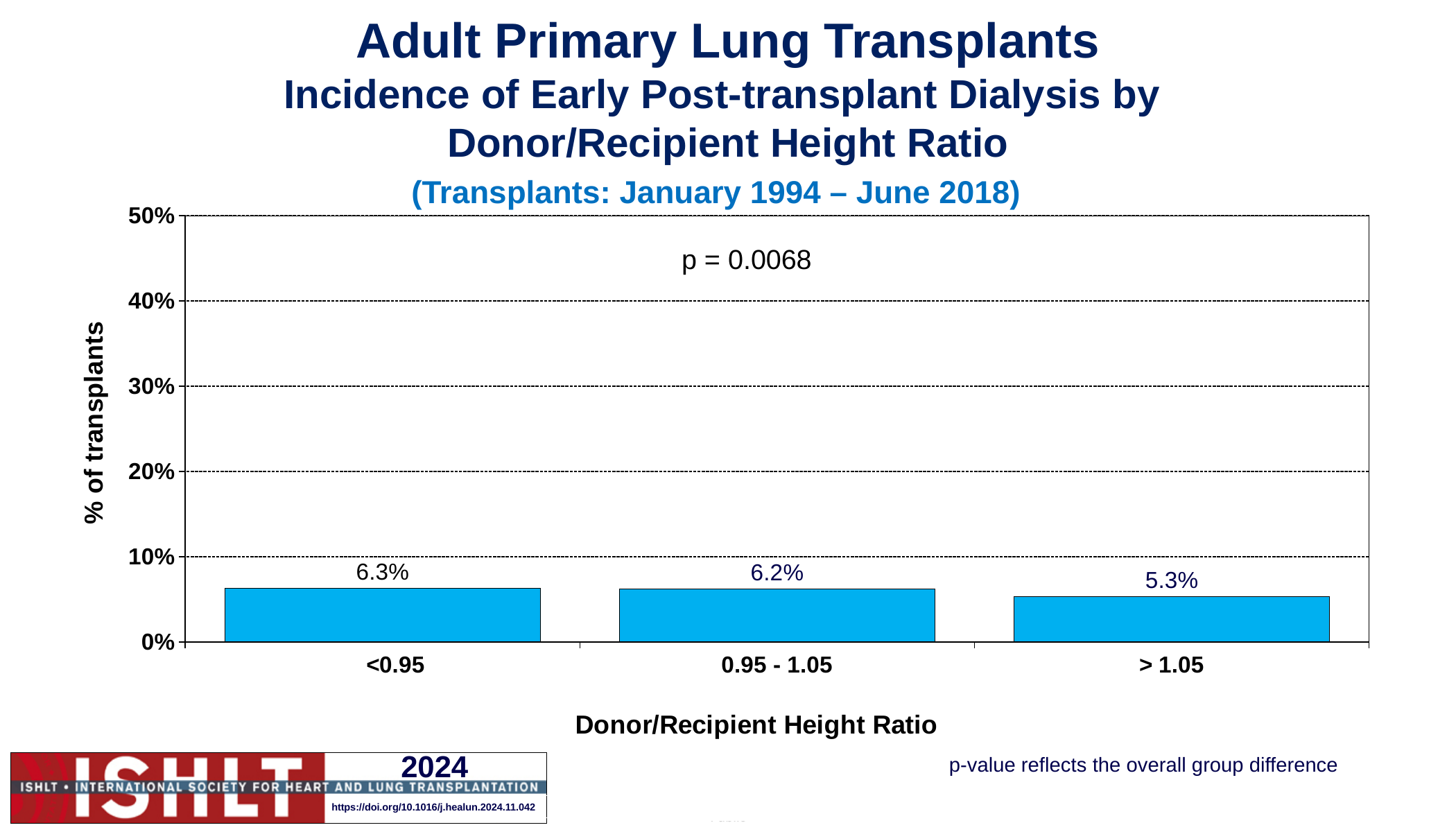
What is the difference in percentage points between the <0.95 group and the > 1.05 group? 1.0 percentage points What type of chart is shown on the slide? Bar chart What is the difference between the 0.95 - 1.05 group and the > 1.05 group? 0.9 percentage points What p-value is printed on the chart? p = 0.0068 What is the value shown for the 0.95 - 1.05 height ratio group? 6.2% What is the percentage of transplants with early post-transplant dialysis for the <0.95 donor/recipient height ratio group? 6.3% How many donor/recipient height ratio categories are shown on the x axis? 3 Which is larger, the value for the <0.95 group or the value for the > 1.05 group? <0.95 Which donor/recipient height ratio group has the lowest incidence of early post-transplant dialysis? > 1.05 What is the value shown for the > 1.05 height ratio group? 5.3% Do the values rise or fall moving from left to right across the height ratio groups? Fall Is the value for the <0.95 group greater or less than 10%? less